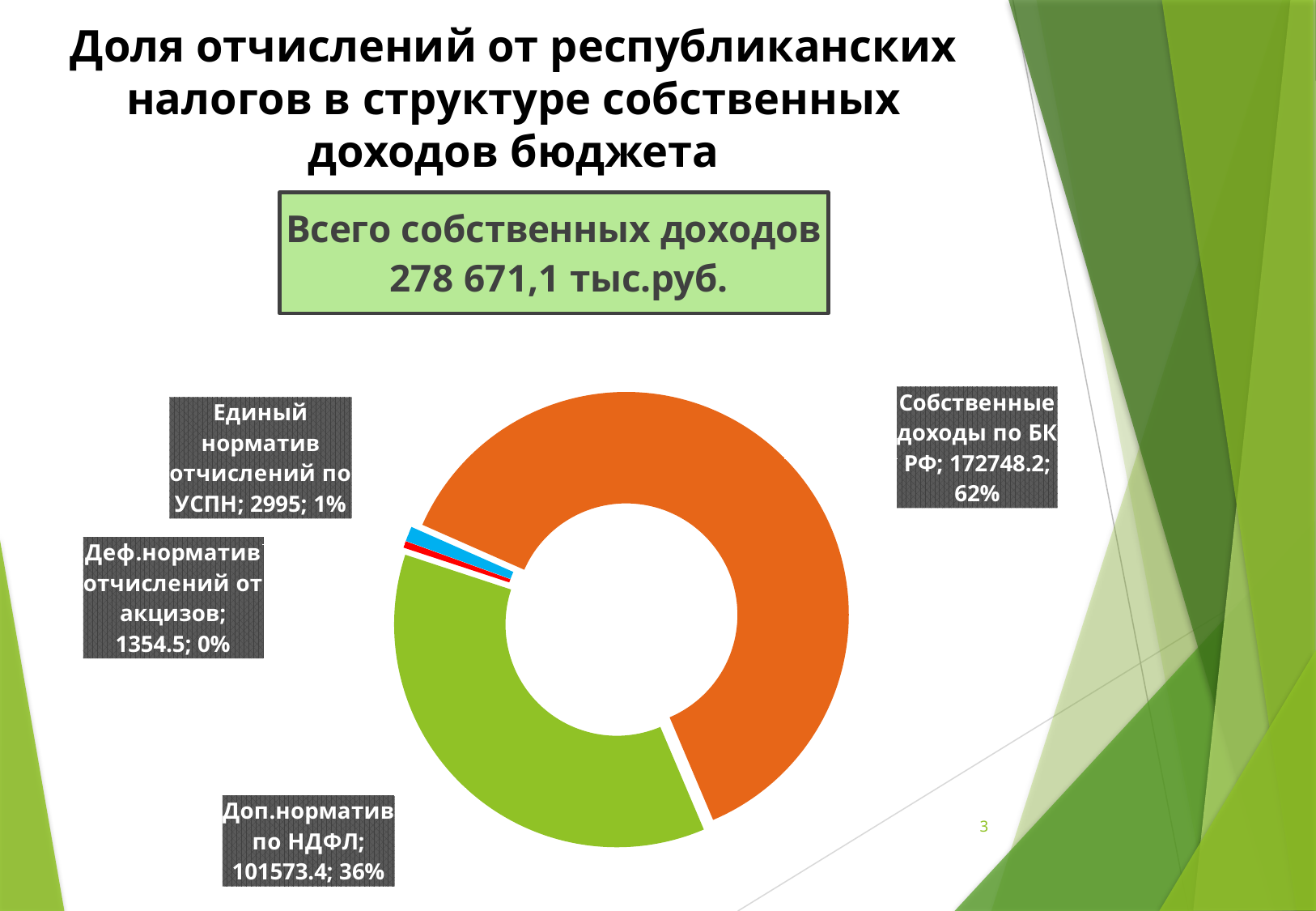
What is the difference between the values for Собственные доходы по БК РФ and Доп.норматив по НДФЛ? 71174.8 What is the value for Собственные доходы по БК РФ? 172748.2 Which category has the largest slice? Собственные доходы по БК РФ Which category has the smallest slice? Деф.норматив отчислений от акцизов What is the value for Единый норматив отчислений по УСПН? 2995 What share of the chart does Собственные доходы по БК РФ represent? 62% How many categories are shown in the chart? 4 Which is larger: Единый норматив отчислений по УСПН or Деф.норматив отчислений от акцизов? Единый норматив отчислений по УСПН What share of the chart does Доп.норматив по НДФЛ represent? 36% What is the value for Деф.норматив отчислений от акцизов? 1354.5 What kind of chart is shown on the slide? Doughnut (pie) chart What is the value for Доп.норматив по НДФЛ? 101573.4